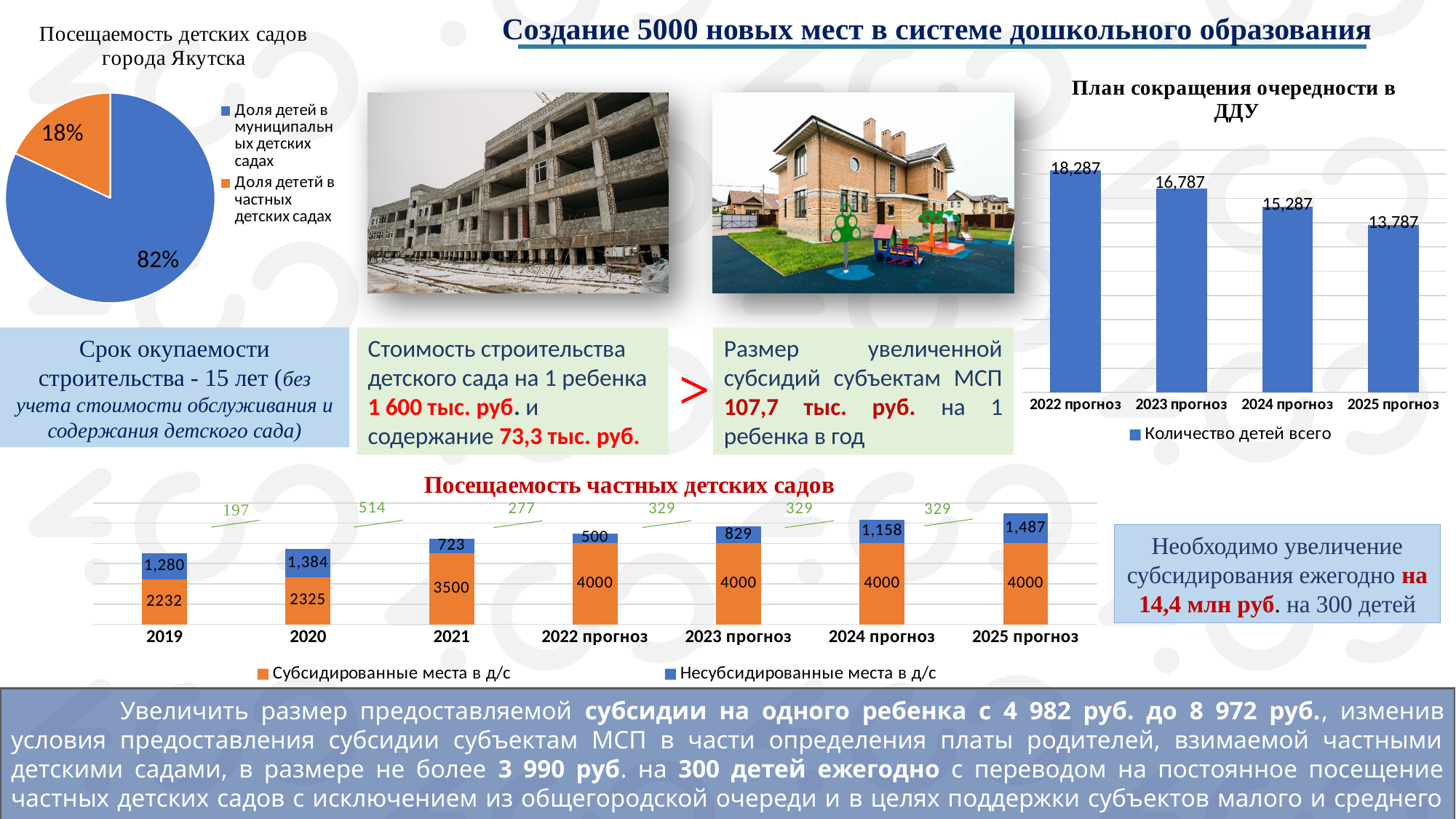
How many categories are shown on the x axis of the chart 'Посещаемость частных детских садов'? 7 In the pie chart 'Посещаемость детских садов города Якутска', what share of children attend municipal kindergartens? 82% In the chart 'План сокращения очередности в ДДУ', do the values rise or fall from 2022 to 2025? Fall How many series does the legend of the chart 'Посещаемость частных детских садов' list? 2 In the chart 'План сокращения очередности в ДДУ', which year has the lowest value? 2025 прогноз In the chart 'План сокращения очередности в ДДУ', what is the difference between the 2022 прогноз and 2025 прогноз values? 4,500 In the pie chart 'Посещаемость детских садов города Якутска', what share of children attend private kindergartens? 18% In the chart 'Посещаемость частных детских садов', what is the value of 'Субсидированные места в д/с' for 2021? 3500 In the chart 'План сокращения очередности в ДДУ', what is the value for 2023 прогноз? 16,787 In the chart 'Посещаемость частных детских садов', what is the value of 'Несубсидированные места в д/с' for 2025 прогноз? 1,487 What kind of chart is 'План сокращения очередности в ДДУ'? Bar chart In the chart 'Посещаемость частных детских садов', what is the total of the stacked bar for 2019? 3,512